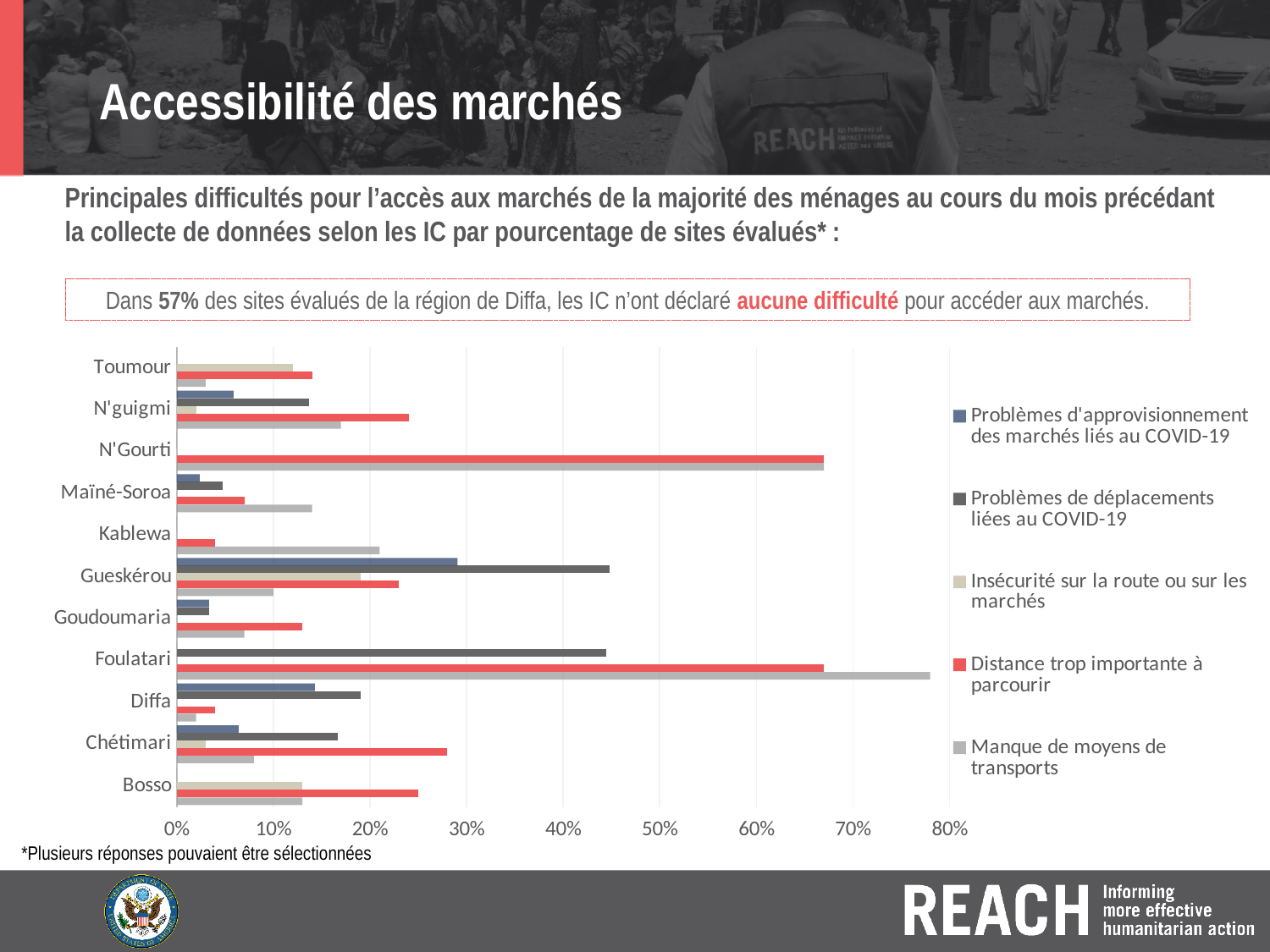
Is the value for 'Problèmes de déplacements liées au COVID-19' in Gueskérou greater or less than 40%? greater Is the value for 'Distance trop importante à parcourir' in Bosso greater or less than 20%? greater Is the value for 'Distance trop importante à parcourir' in Chétimari greater or less than 30%? less What kind of chart is shown on the slide? Bar chart According to the highlighted text above the chart, in what percentage of assessed sites in the Diffa region did the IC report no difficulty accessing markets? 57% How many series does the chart legend list? 5 Which is larger: the 'Distance trop importante à parcourir' value for Chétimari or for Diffa? Chétimari How many sites (categories) are listed on the vertical axis of the chart? 11 Which site has the highest value for 'Problèmes d'approvisionnement des marchés liés au COVID-19'? Gueskérou Which site has the highest value for 'Manque de moyens de transports'? Foulatari